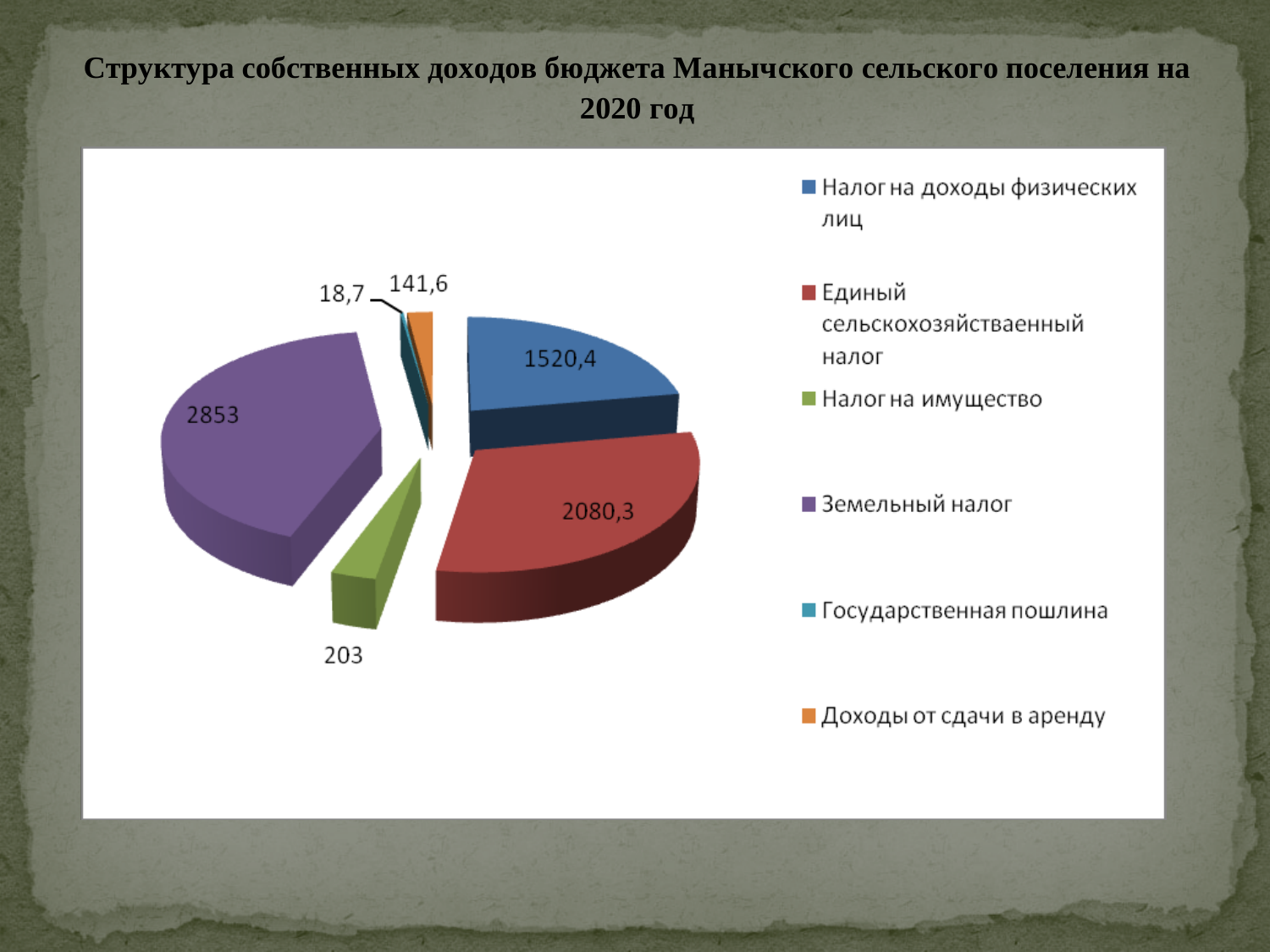
Which category has the smallest slice of the pie? Государственная пошлина What is the difference between the values for Земельный налог and Единый сельскохозяйственный налог? 772,7 What is the value for Единый сельскохозяйственный налог? 2080,3 Which category has the largest slice of the pie? Земельный налог Which is larger: Единый сельскохозяйственный налог or Налог на доходы физических лиц? Единый сельскохозяйственный налог What is the value for Государственная пошлина? 18,7 What is the difference between the values for Налог на имущество and Доходы от сдачи в аренду? 61,4 What is the value for Земельный налог? 2853 What is the value for Налог на доходы физических лиц? 1520,4 What type of chart is shown on the slide? Pie chart What colour is the slice for Земельный налог? Purple How many categories does the pie chart show? 6